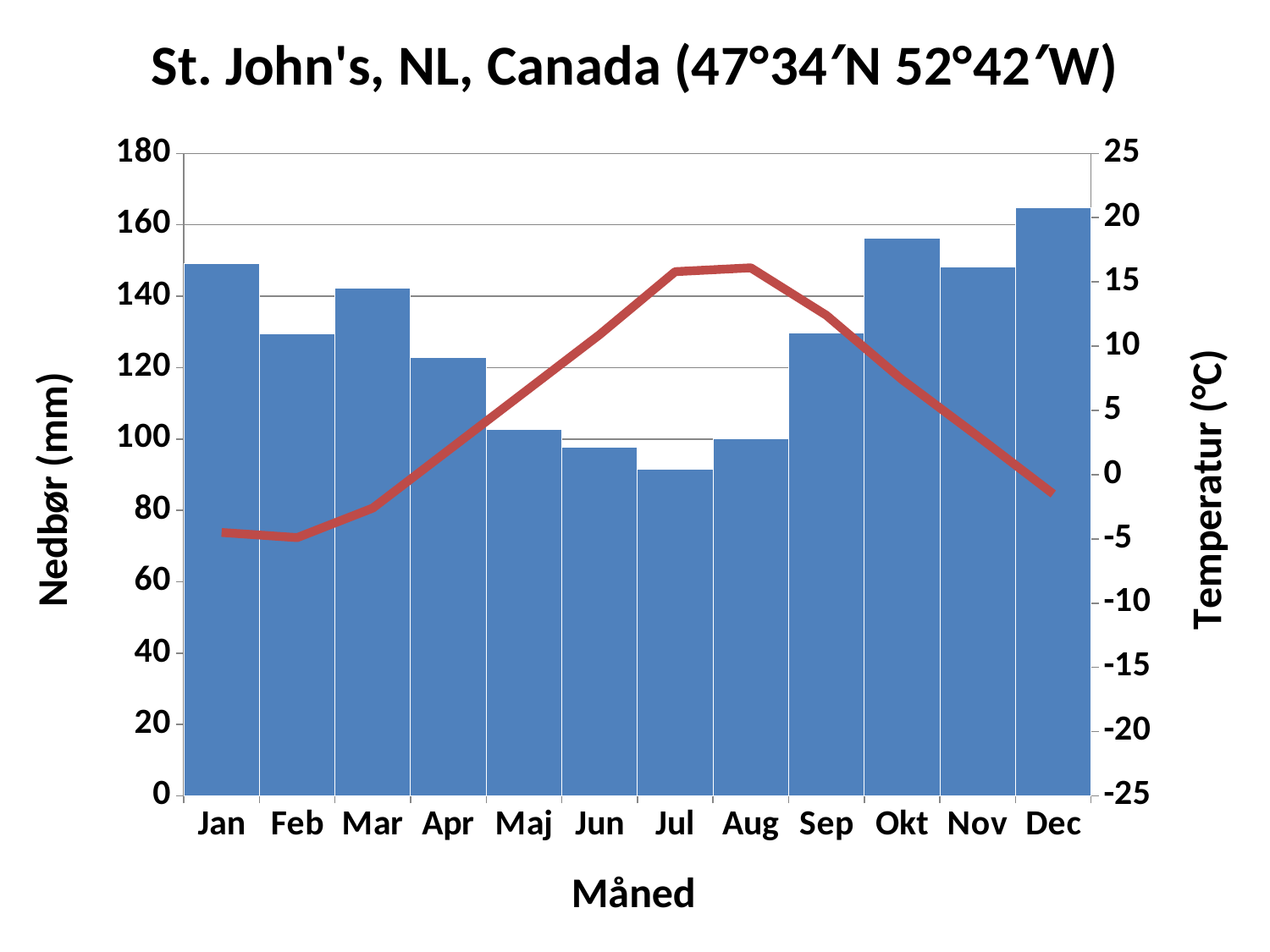
Does the temperature line rise or fall from Feb to Aug? rise What is the title of the chart? St. John's, NL, Canada (47°34′N 52°42′W) How many months are shown along the x axis? 12 Is the precipitation value for Jul greater or less than 100 mm? less Is the precipitation value for Dec greater or less than 160 mm? greater Is the precipitation value for Jan greater or less than 140 mm? greater Which month has the larger precipitation bar, Sep or Okt? Okt Which month has the lowest precipitation (Nedbør) bar? Jul What kind of chart is shown on the slide? A combined bar and line chart Which month has the highest precipitation (Nedbør) bar? Dec